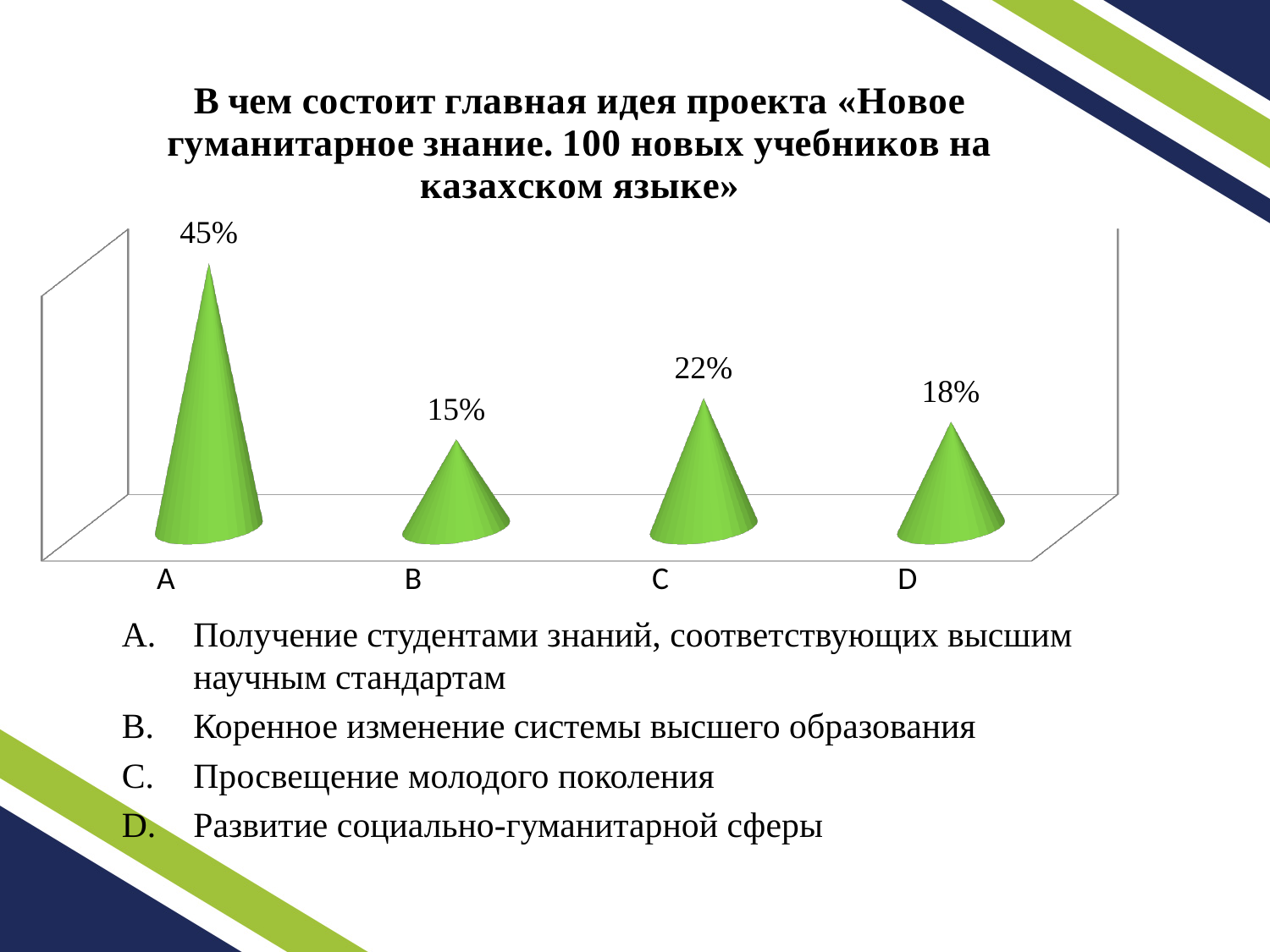
What is the value for category D? 18% Which is larger, the value for C or the value for D? C What is the value for category C? 22% What is the total of the four values shown on the chart? 100% What is the value for category A? 45% What is the value for category B? 15% What kind of chart is shown on the slide? bar chart What is the difference between the values for C and D? 4% Which category has the lowest value? B What is the difference between the values for A and C? 23% Which category has the highest value? A How many categories are shown on the chart? 4